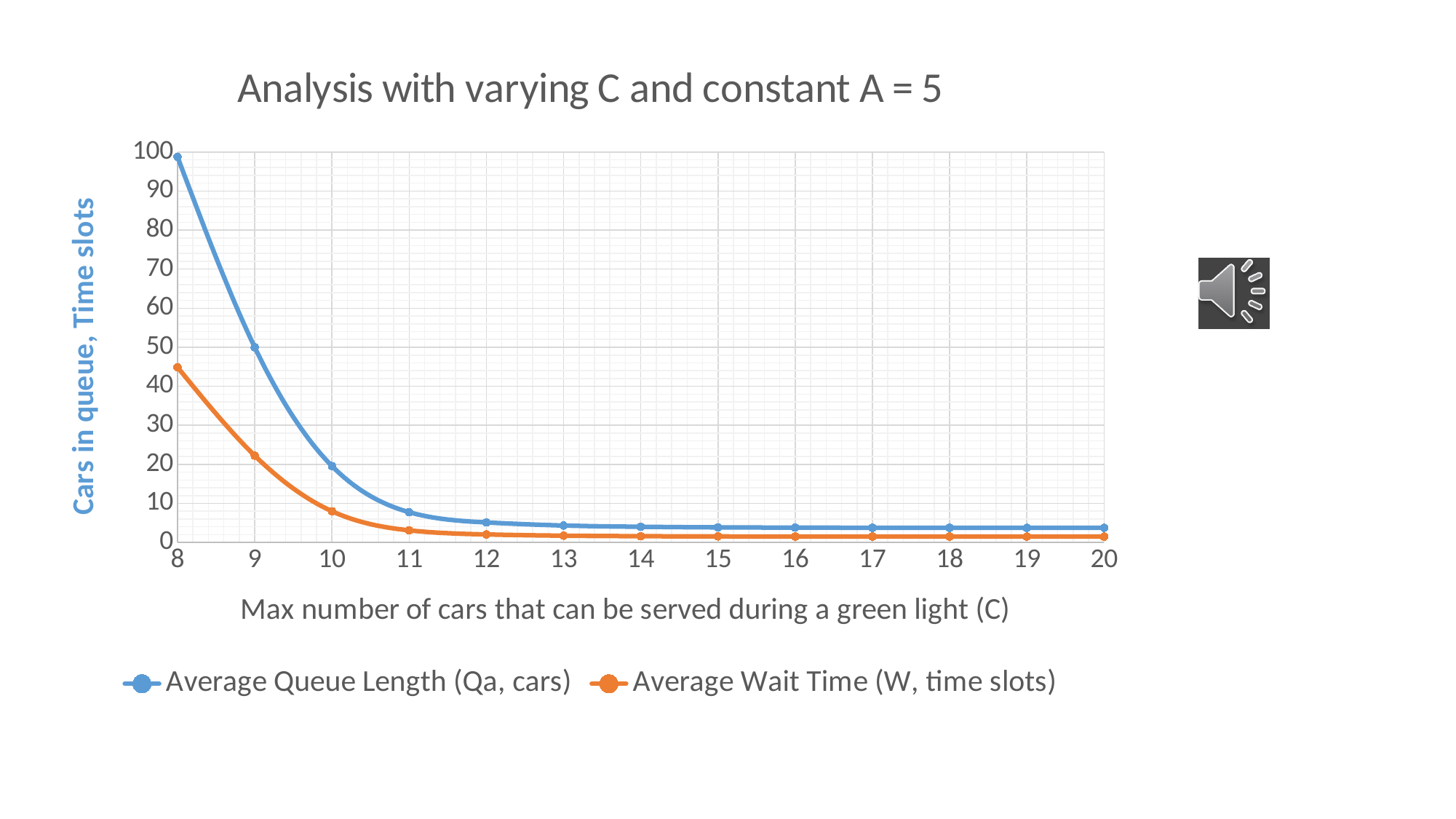
Is the Average Queue Length at C = 8 greater or less than 90? greater How many series does the legend list? 2 At which value of C is the Average Queue Length highest? 8 Is the Average Wait Time at C = 10 greater or less than 10? less Do the Average Queue Length values rise or fall as C increases from 8 to 20? fall Is the Average Queue Length at C = 9 greater or less than 40? greater What is the label of the x axis? Max number of cars that can be served during a green light (C) How many values of C are plotted along the x axis? 13 What is the title of the chart? Analysis with varying C and constant A = 5 At C = 8, which series has the larger value, Average Queue Length or Average Wait Time? Average Queue Length What kind of chart is shown on the slide? line chart